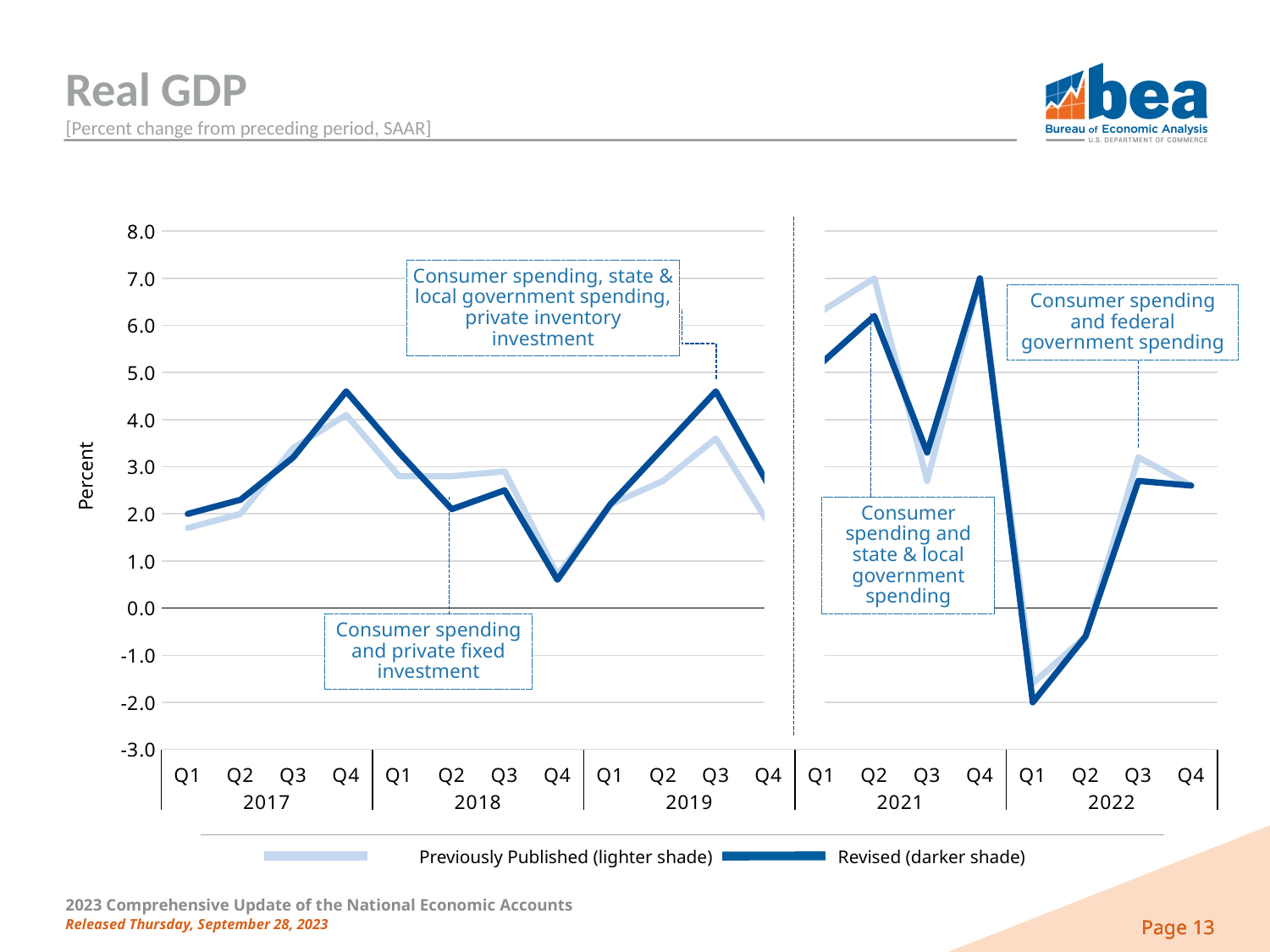
How many series does the legend list? 2 Is the Revised value for Q4 2018 greater or less than 1.0? less In which quarter does the Revised (darker shade) series reach its lowest value? Q1 2022 In which quarter does the Revised (darker shade) series reach its highest value? Q4 2021 Is the Previously Published value for Q2 2021 greater or less than 6.0? greater How many years are labeled on the x axis? 5 What is the title of the chart? Real GDP Does the Revised series rise or fall from Q4 2021 to Q1 2022? fall How many quarterly data points are plotted along the x axis? 20 Is the Revised value for Q4 2017 greater or less than 4.0? greater What kind of chart is shown on the slide? line chart Which is larger for the Revised series: the value for Q4 2017 or the value for Q4 2018? Q4 2017